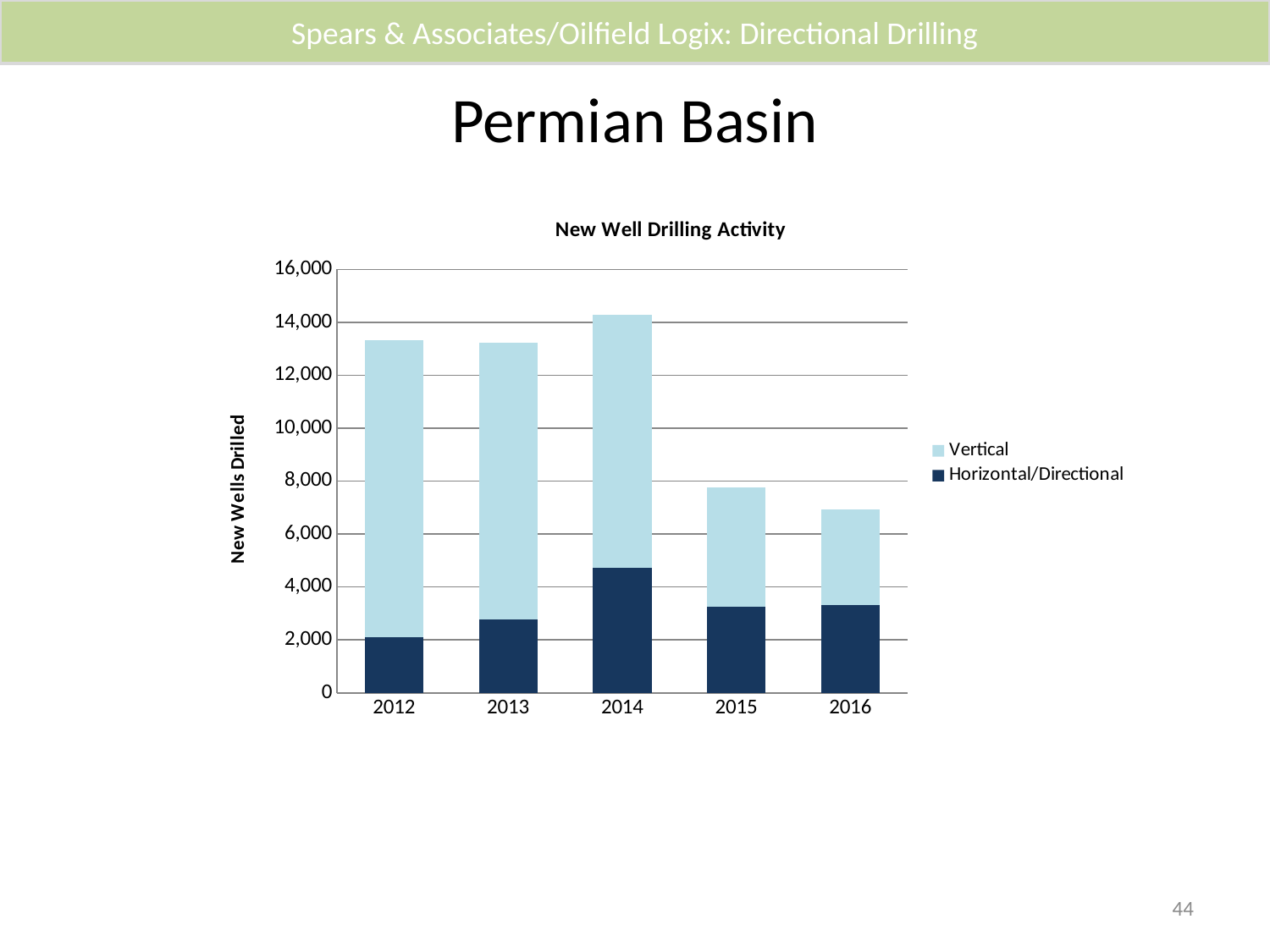
Does the total number of new wells drilled rise or fall from 2014 to 2016? fall Is the total number of new wells drilled in 2016 greater or less than 8,000? less Which year has the lowest total number of new wells drilled? 2016 How many years are shown on the x axis of the chart? 5 Which year has the smallest Horizontal/Directional segment? 2012 Which is larger, the Horizontal/Directional value for 2013 or for 2014? 2014 What kind of chart is shown on the slide? stacked bar chart Is the Horizontal/Directional value for 2014 greater or less than 4,000? greater Which year has the highest total number of new wells drilled? 2014 Is the total number of new wells drilled in 2014 greater or less than 12,000? greater Which year has the largest Horizontal/Directional segment? 2014 How many series does the legend list? 2